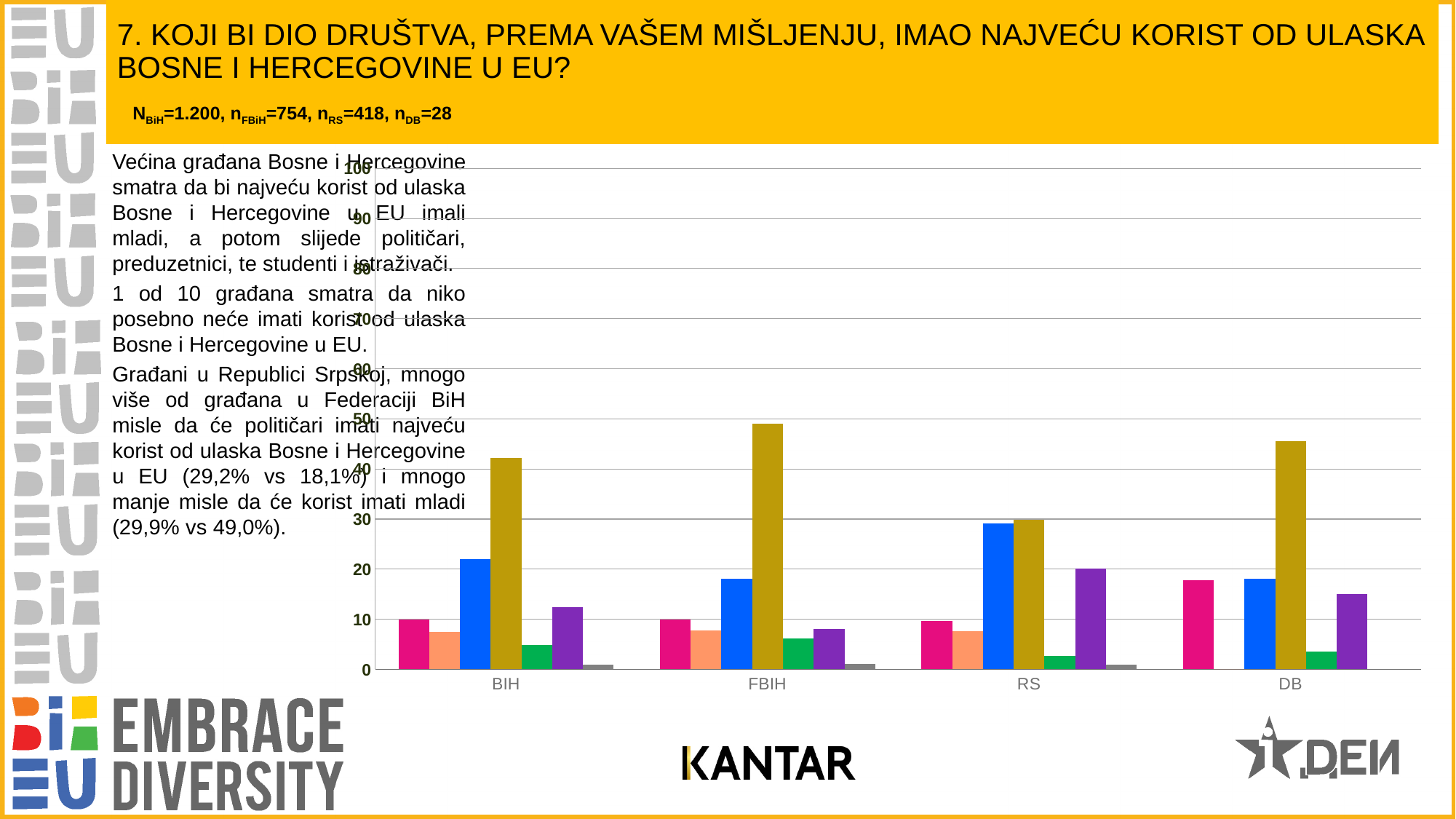
Which colour bar is the tallest in the BIH group? gold What is the highest value shown on the y axis of the chart? 100 Is the gold bar for FBIH greater or less than 40? greater How many categories are shown on the x axis of the chart? 4 Is the gold bar for DB greater or less than 40? greater Which colour bar is the tallest in the FBIH group? gold Is the magenta bar for DB greater or less than 20? less Which is larger, the gold bar for FBIH or the gold bar for RS? the gold bar for FBIH Which colour bar is the shortest in the BIH group? gray What kind of chart is shown on the slide? bar chart